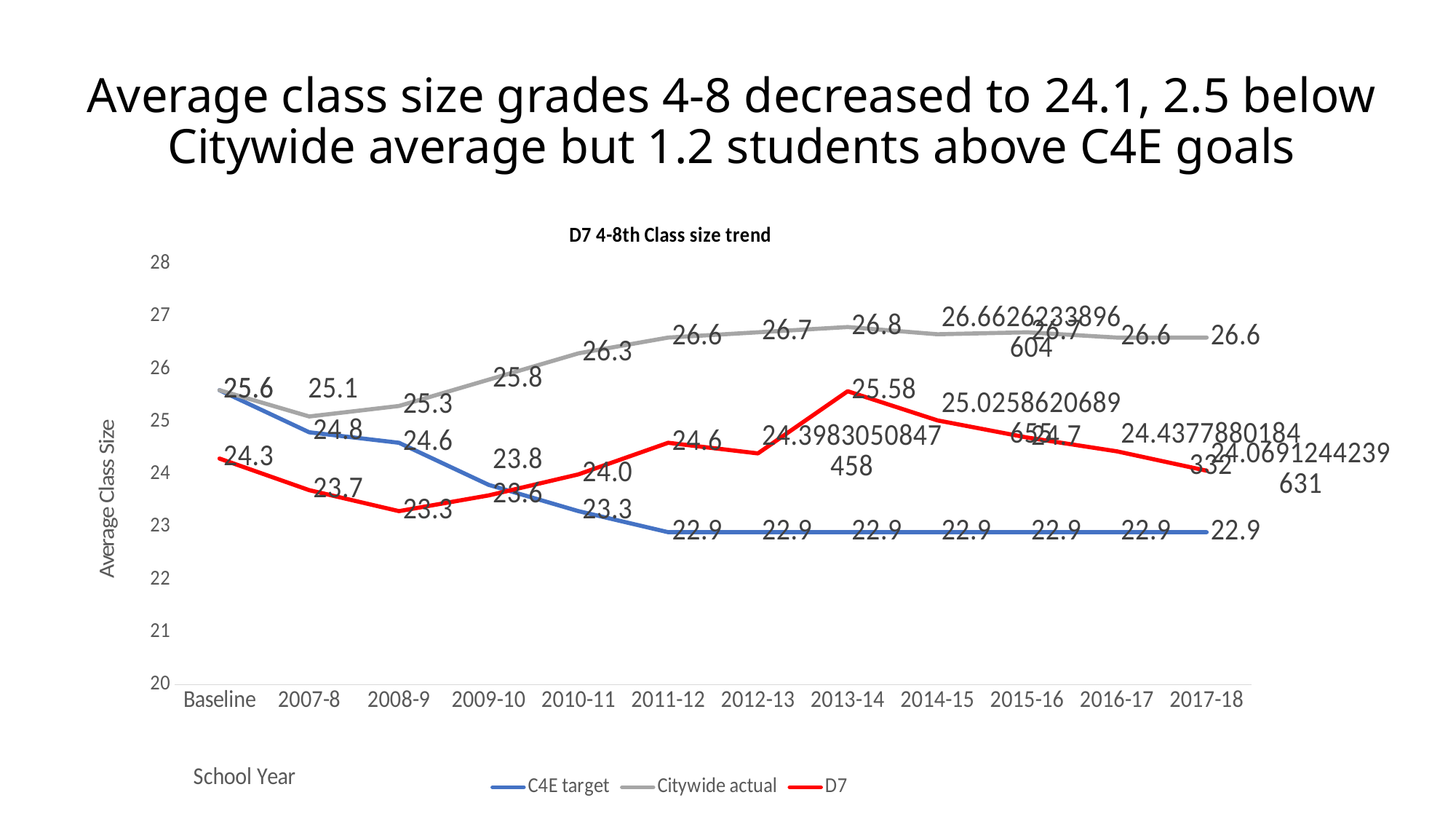
What is the C4E target value for 2017-18? 22.9 Does the C4E target series rise or fall from Baseline to 2011-12? fall How many series does the legend list? 3 What is the title of the chart? D7 4-8th Class size trend What kind of chart is shown on the slide? line chart What is the difference between the Citywide actual and the C4E target in 2013-14? 3.9 In 2009-10, which is larger: the C4E target or the D7 value? C4E target How many school years are plotted along the x axis? 12 In which school year is the D7 series at its lowest value? 2008-9 What is the Citywide actual value for 2013-14? 26.8 What is the D7 value at Baseline? 24.3 In which school year does the D7 series reach its highest value? 2013-14